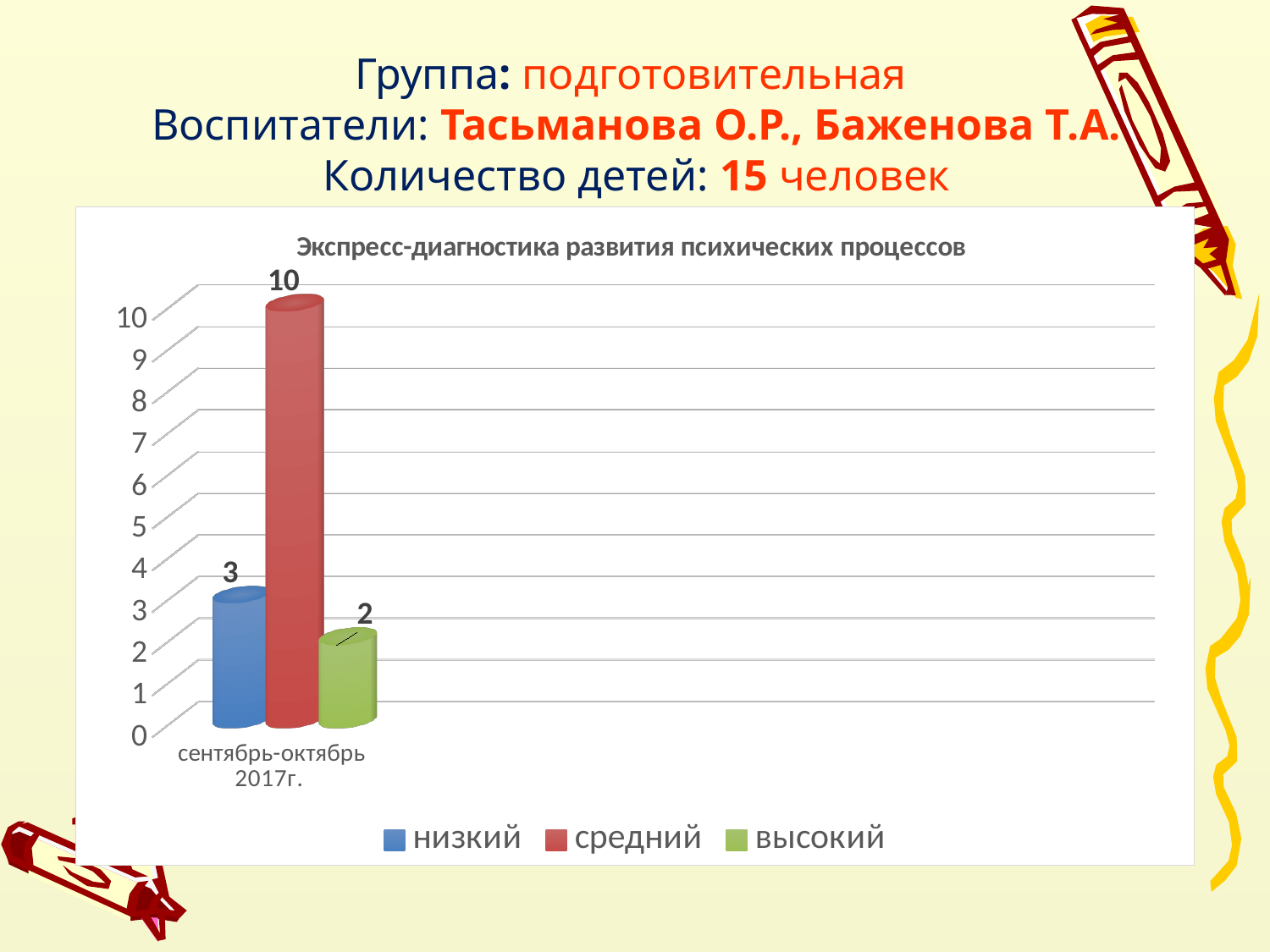
What kind of chart is this? bar chart What is the value for средний in сентябрь-октябрь 2017г.? 10 Which series has the highest value? средний What is the difference between the values for низкий and высокий? 1 Which series has the lowest value? высокий What is the value for низкий in сентябрь-октябрь 2017г.? 3 Which is larger, the value for низкий or the value for высокий? низкий What is the title of the chart? Экспресс-диагностика развития психических процессов How many categories are shown on the x axis? 1 What is the value for высокий in сентябрь-октябрь 2017г.? 2 What is the difference between the values for средний and низкий? 7 How many series does the legend list? 3